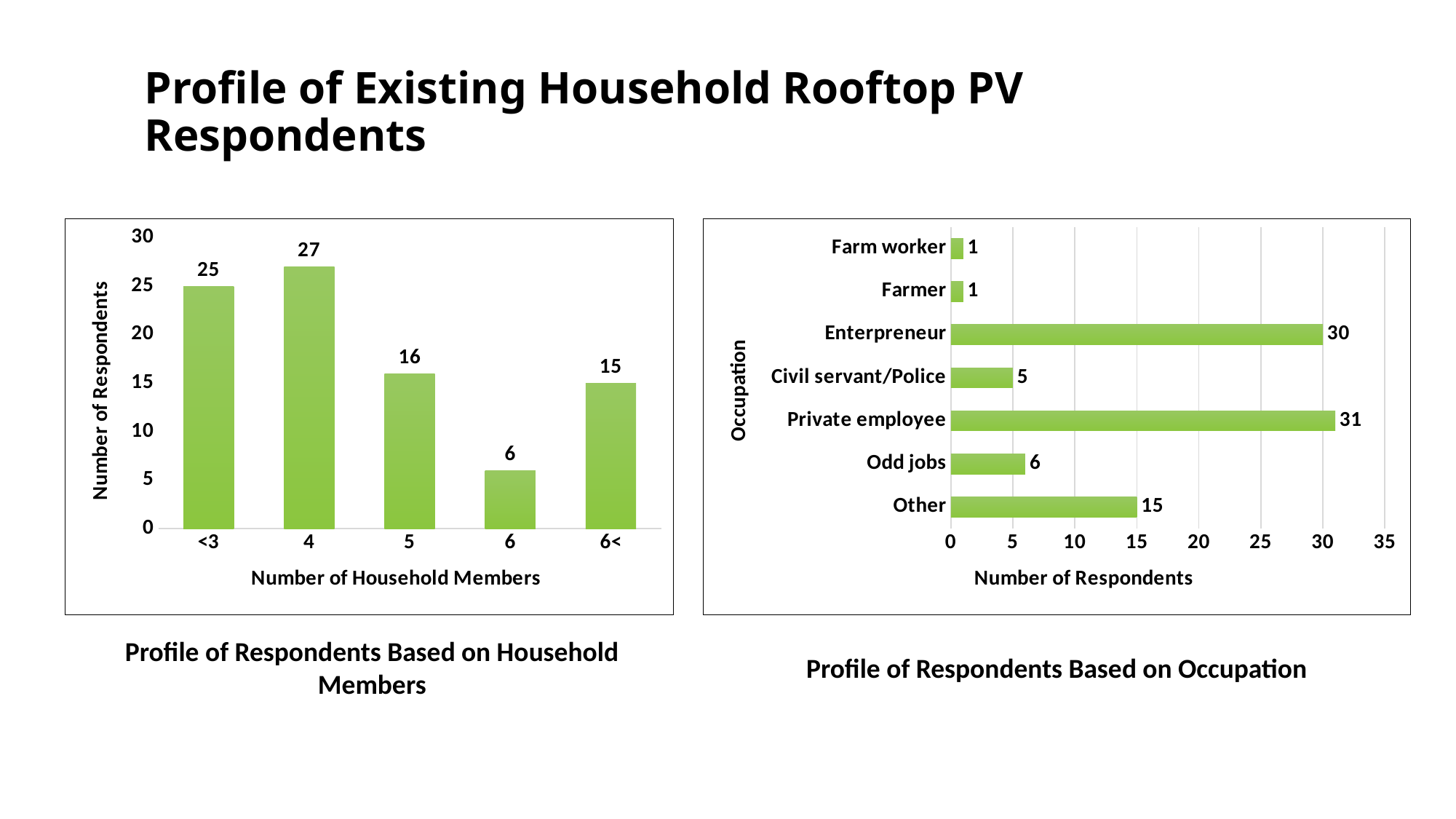
In the 'Profile of Respondents Based on Household Members' chart, what is the difference between the number of respondents with <3 household members and those with 5 household members? 9 In the 'Profile of Respondents Based on Occupation' chart, which has more respondents, Odd jobs or Other? Other In the 'Profile of Respondents Based on Occupation' chart, how many occupation categories are listed? 7 In the 'Profile of Respondents Based on Household Members' chart, how many respondents have 4 household members? 27 In the 'Profile of Respondents Based on Household Members' chart, which household size category has the lowest number of respondents? 6 In the 'Profile of Respondents Based on Household Members' chart, which household size category has the highest number of respondents? 4 What is the label on the x axis of the 'Profile of Respondents Based on Occupation' chart? Number of Respondents In the 'Profile of Respondents Based on Occupation' chart, what is the difference between the number of Enterpreneur respondents and Other respondents? 15 In the 'Profile of Respondents Based on Occupation' chart, how many respondents are civil servants/police? 5 What kind of chart is 'Profile of Respondents Based on Household Members'? Bar chart In the 'Profile of Respondents Based on Household Members' chart, how many household size categories are shown? 5 In the 'Profile of Respondents Based on Occupation' chart, which occupation has the most respondents? Private employee